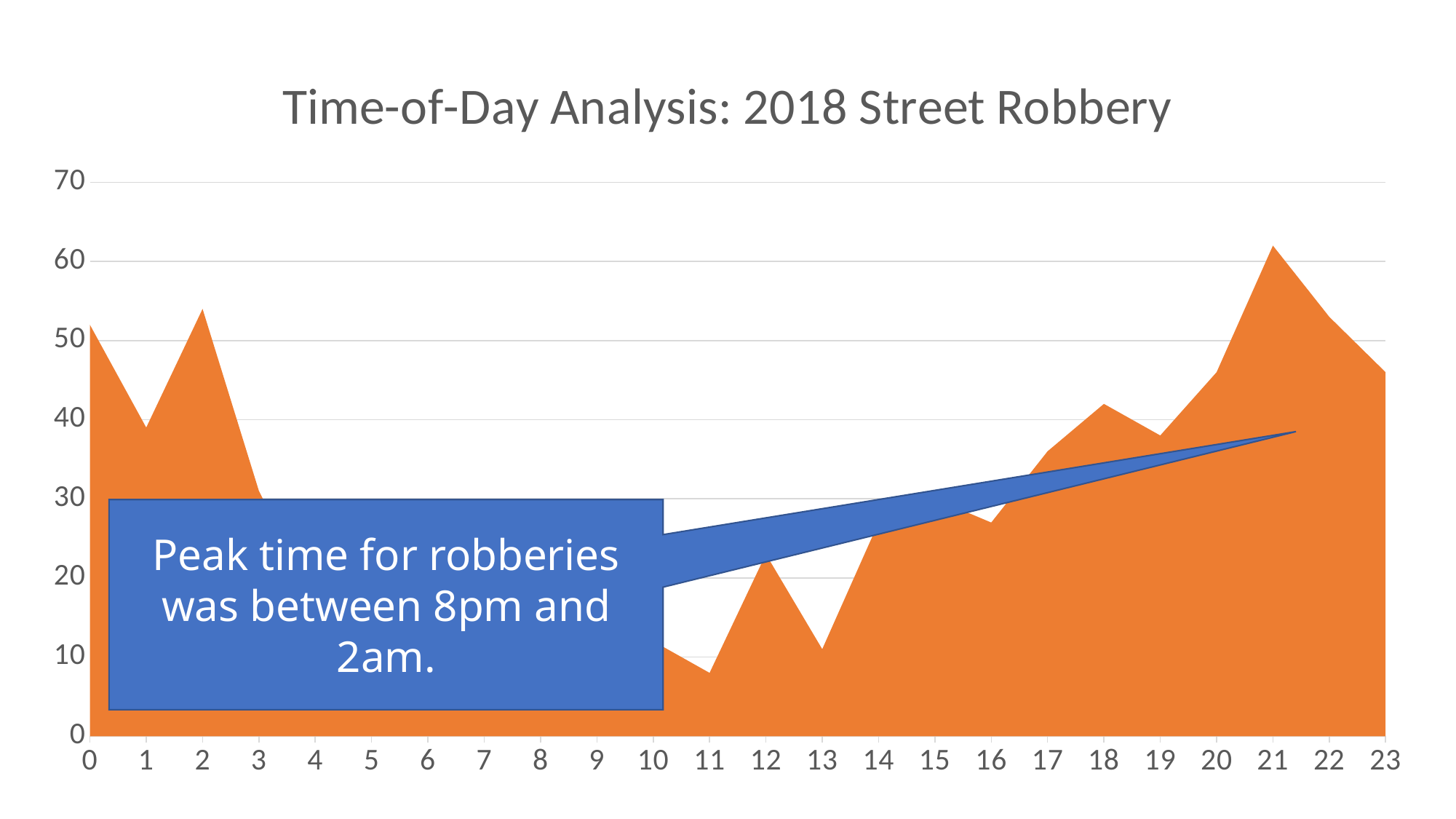
Which hour has the larger value, hour 0 or hour 1? Hour 0 Is the value at hour 13 greater or less than 20? less How many hours (points) are plotted along the x axis? 24 Is the value at hour 18 greater or less than 30? greater What is the title of the chart? Time-of-Day Analysis: 2018 Street Robbery Which hour has the larger value, hour 13 or hour 14? Hour 14 At which hour does the chart reach its highest value? 21 What kind of chart is shown on the slide? Area chart Is the value at hour 0 greater or less than 40? greater Do the values rise or fall from hour 17 to hour 21 overall? Rise